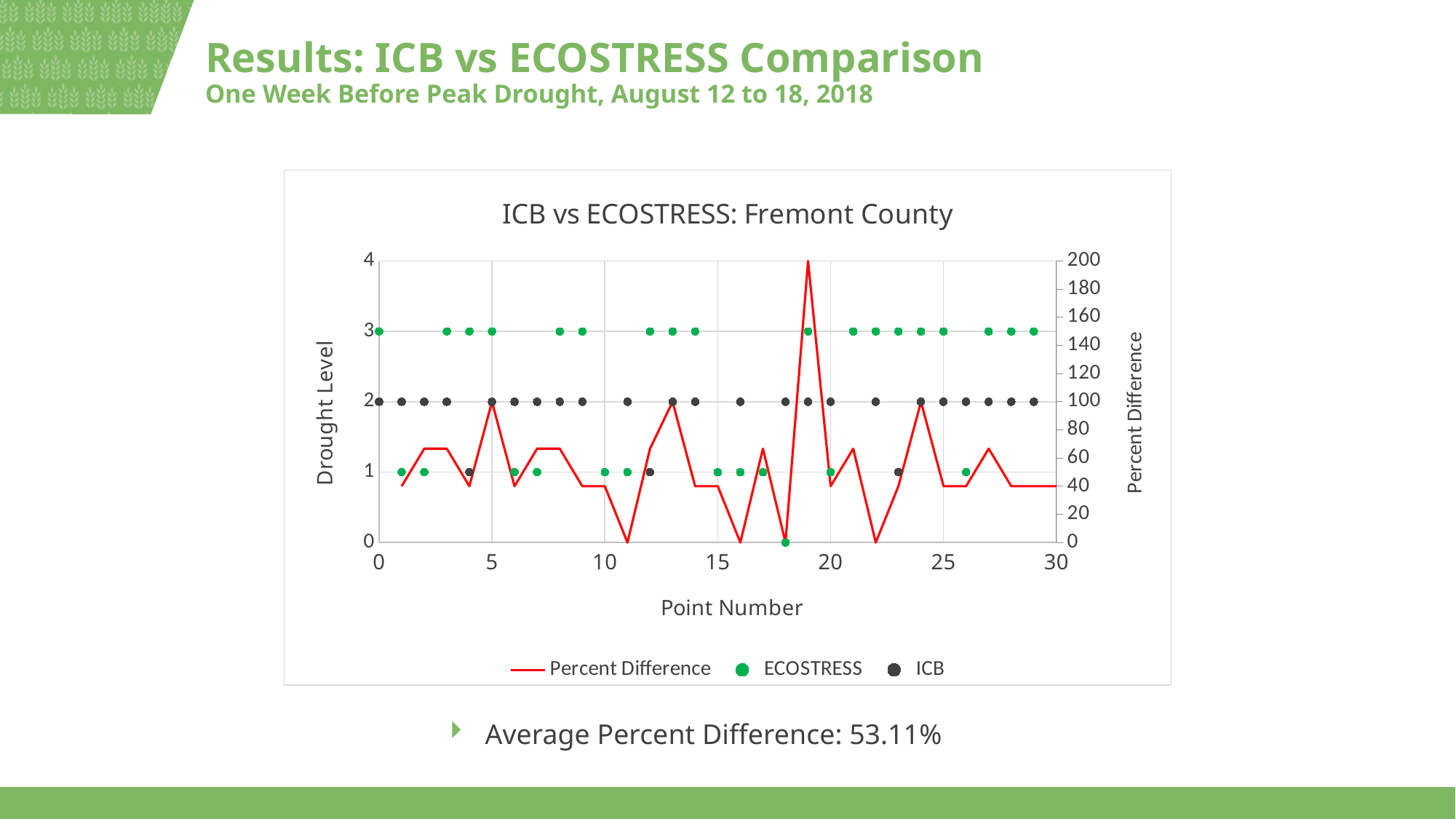
At point number 4, which series shows the higher drought level, ECOSTRESS or ICB? ECOSTRESS What is the ECOSTRESS drought level at point number 0? 3 What is the label of the right-hand vertical axis? Percent Difference At which point number does the Percent Difference line reach its highest value? 19 What is the ICB drought level at point number 0? 2 What is the Percent Difference value at point number 19? 200 What is the ECOSTRESS drought level at point number 18? 0 What is the Percent Difference value at point number 11? 0 What is the difference between the ECOSTRESS and ICB drought levels at point number 0? 1 How many series does the chart legend list? 3 Is the Percent Difference value at point number 1 greater or less than 60? less What is the title of the chart? ICB vs ECOSTRESS: Fremont County